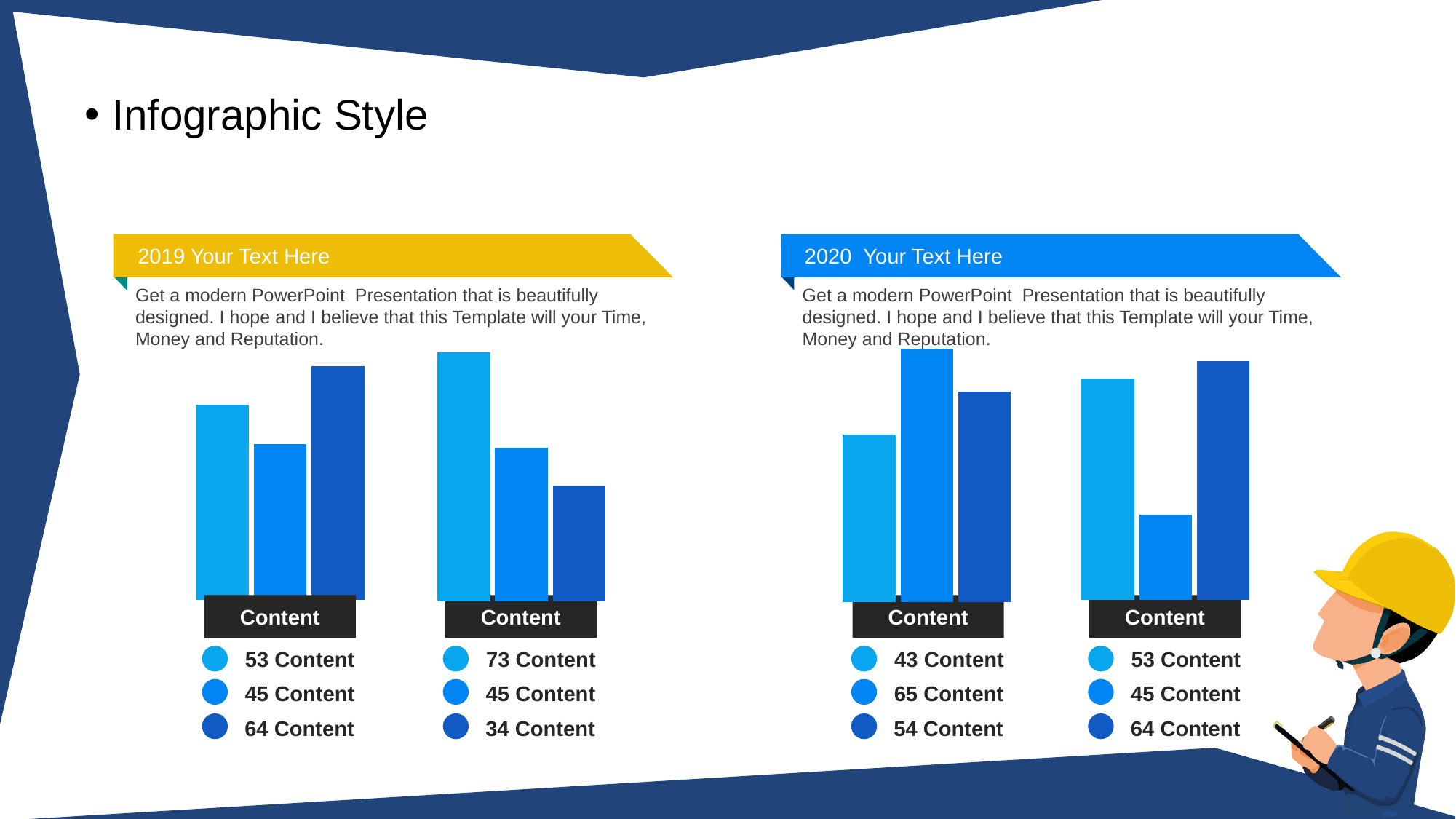
In the right chart under the 2019 heading, which bar is the lowest? The dark blue (third) bar, 34 In the right chart under the 2019 heading, what is the value of the light blue (first) bar? 73 How many bars does each of the four charts on the slide have? 3 In the right chart under the 2019 heading, what is the difference between the first bar (73) and the third bar (34)? 39 In the left chart under the 2019 heading, what is the value of the dark blue (third) bar? 64 In the left chart under the 2020 heading, what is the difference between the highest bar (65) and the lowest bar (43)? 22 In the left chart under the 2019 heading, which is larger: the light blue bar or the medium blue bar? The light blue bar (53) What type of chart is used under the 2019 and 2020 headings? Bar chart Do the bar values in the right chart under the 2019 heading rise or fall from left to right? Fall In the left chart under the 2020 heading, which bar is the highest? The medium blue (second) bar, 65 In the left chart under the 2019 heading, what is the value of the light blue (first) bar? 53 In the right chart under the 2020 heading, what is the value of the medium blue (second) bar? 45